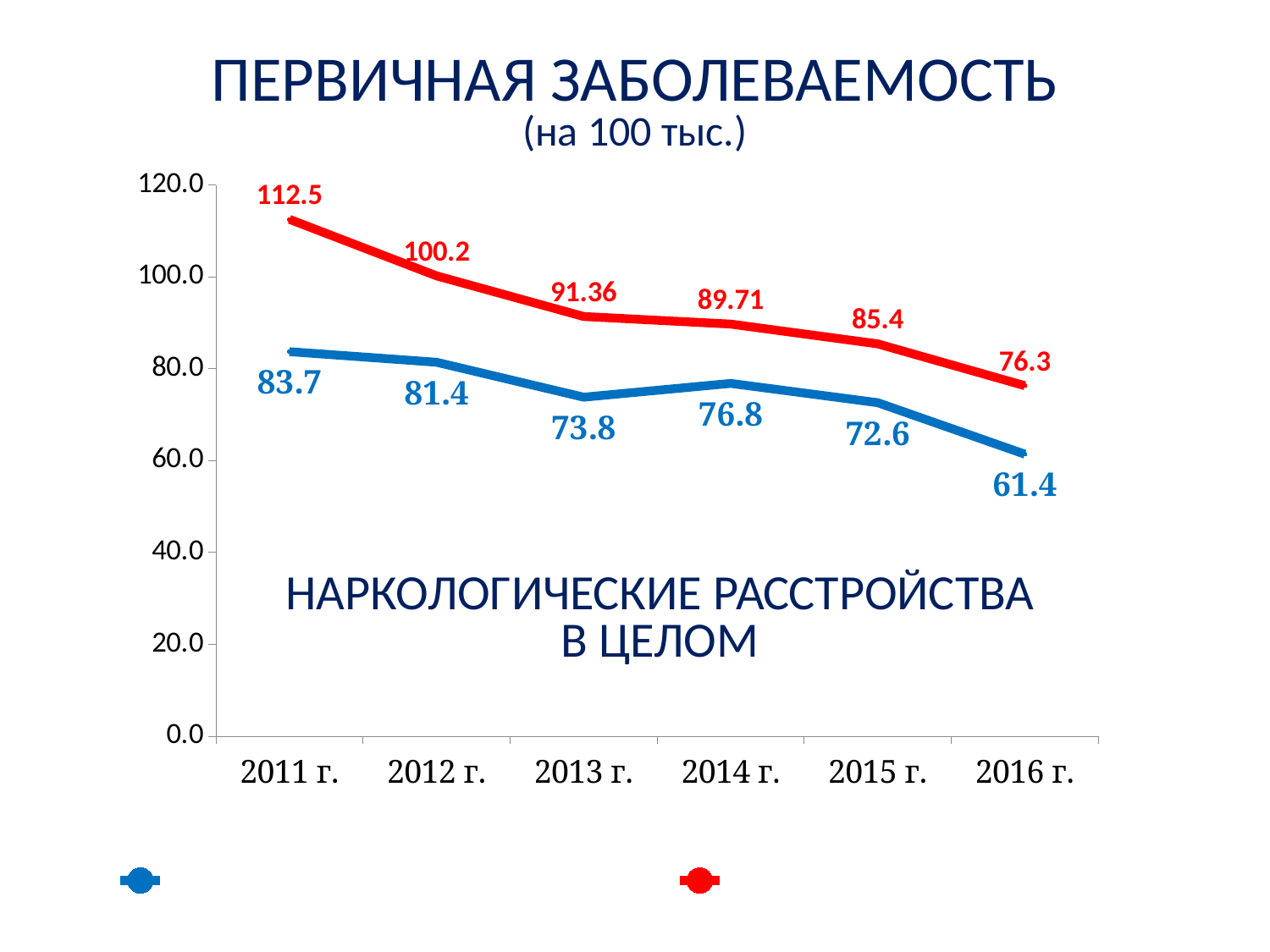
What kind of chart is shown on the slide? line chart In which year does the red line reach its highest value? 2011 г. How many years are shown on the x axis? 6 What is the value of the red line for 2011 г.? 112.5 What is the value of the blue line for 2016 г.? 61.4 What is the value of the blue line for 2013 г.? 73.8 How many series does the legend show? 2 In which year does the blue line reach its lowest value? 2016 г. Which is larger: the blue line's value in 2012 г. or its value in 2014 г.? 2012 г. Does the red line generally rise or fall from 2011 г. to 2016 г.? fall What is the difference between the red line and the blue line in 2016 г.? 14.9 What is the value of the red line for 2014 г.? 89.71